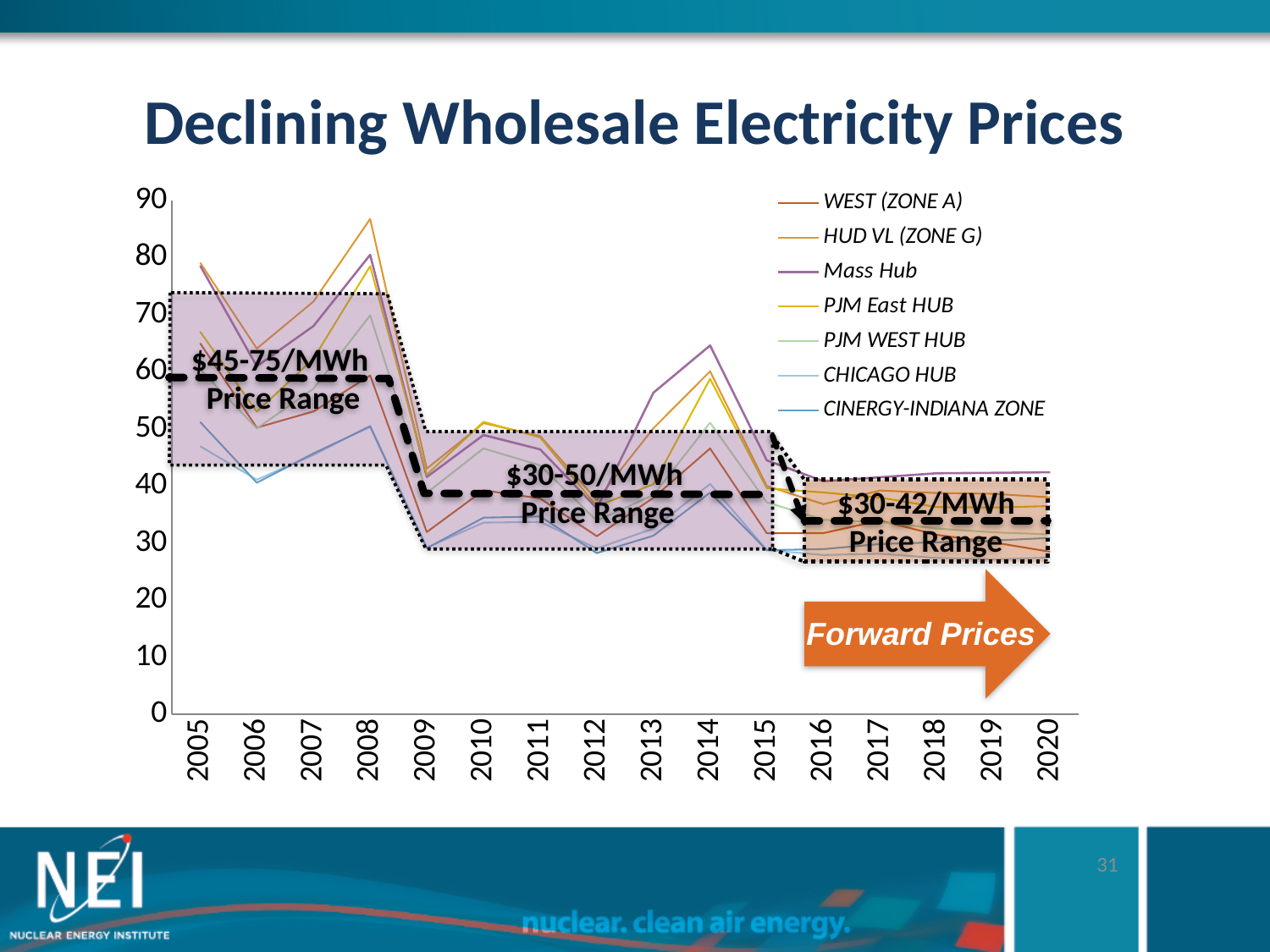
What is the first year shown on the x axis? 2005 How many years are shown along the x axis? 16 Overall, do the wholesale electricity prices rise or fall from 2005 to 2020? fall Is the value for Mass Hub in 2005 greater or less than 70? greater What is the last year shown on the x axis? 2020 What kind of chart is shown on the slide? line chart Is the value for WEST (ZONE A) in 2009 greater or less than 40? less Is the value for HUD VL (ZONE G) in 2008 greater or less than 80? greater What price range is annotated for the 2016-2020 forward prices period? $30-42/MWh In which year does the highest value on the chart occur? 2008 What is the title of the chart? Declining Wholesale Electricity Prices How many series does the legend list? 7